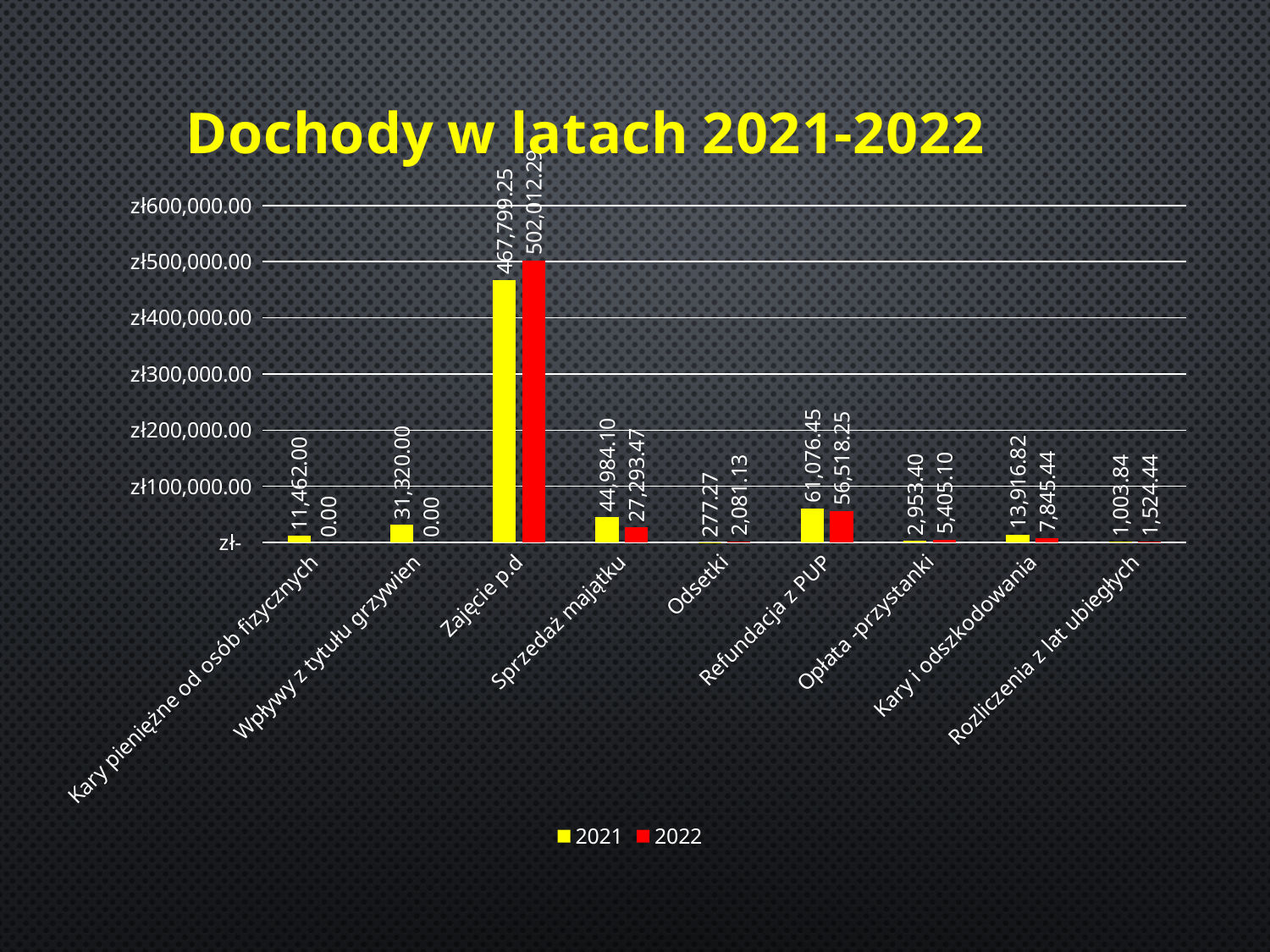
What is the 2022 value for Refundacja z PUP? 56,518.25 Which category has the lowest 2021 value? Odsetki How many categories are shown on the x axis? 9 What is the difference between the 2022 and 2021 values for Zajęcie p.d? 34,213.04 What is the 2021 value for Zajęcie p.d? 467,799.25 What type of chart is shown on the slide? Bar chart For Kary i odszkodowania, which year has the larger value, 2021 or 2022? 2021 What is the difference between the 2021 and 2022 values for Sprzedaż majątku? 17,690.63 What is the 2022 value for Odsetki? 2,081.13 How many series does the legend list? 2 Which category has the highest 2022 value? Zajęcie p.d What is the 2021 value for Wpływy z tytułu grzywien? 31,320.00